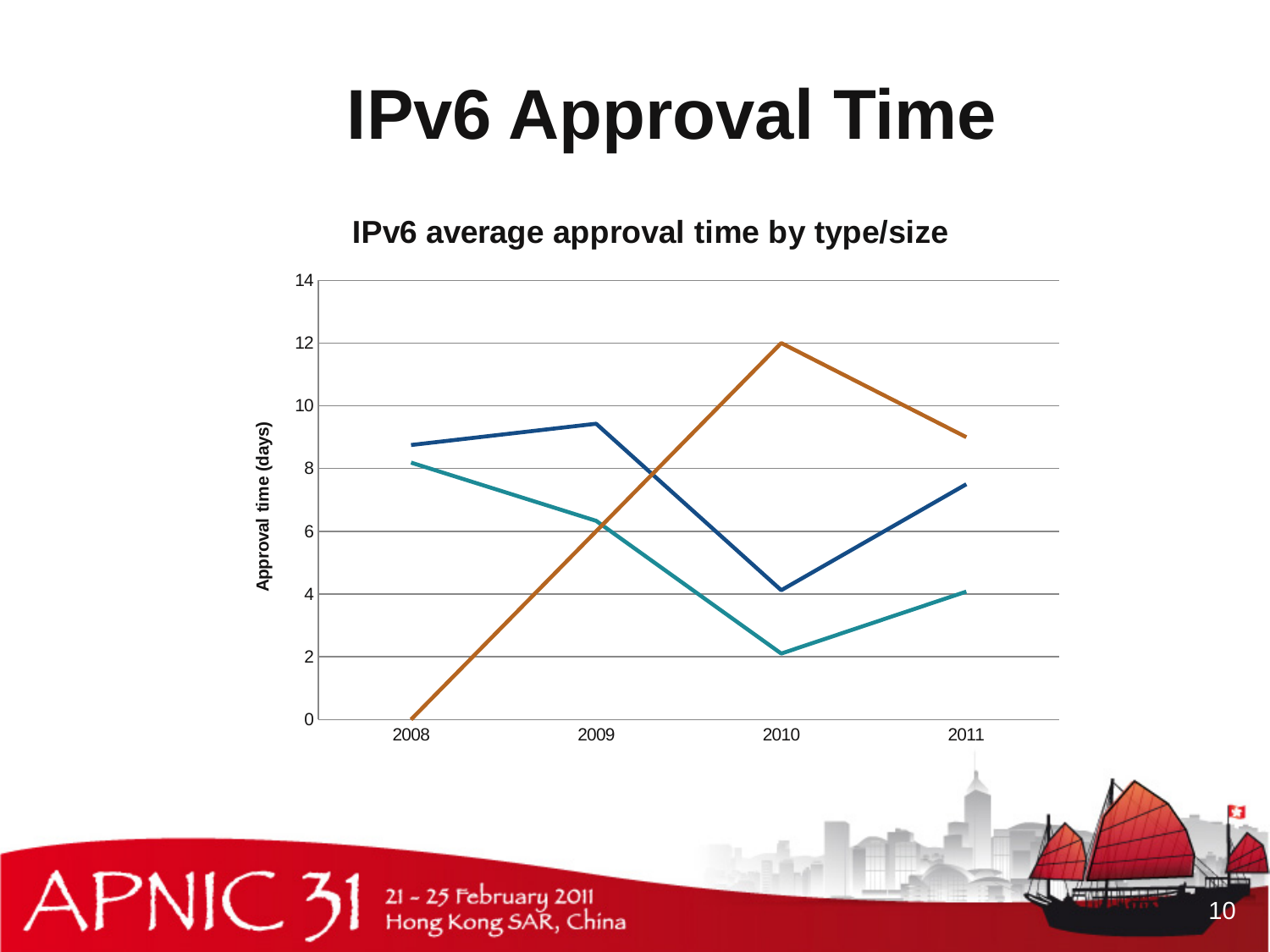
Which line has the higher value in 2011, the orange line or the teal line? orange line Is the value of the dark blue line in 2010 greater or less than 6? less What is the label on the vertical axis of the chart? Approval time (days) What is the title of the chart? IPv6 average approval time by type/size What kind of chart is shown on the slide? line chart In which year does the orange line reach its highest value? 2010 How many years are shown along the x axis of the chart? 4 What is the value of the orange line in 2010? 12 In which year does the teal line reach its lowest value? 2010 What is the value of the orange line in 2008? 0 How many lines are plotted on the chart? 3